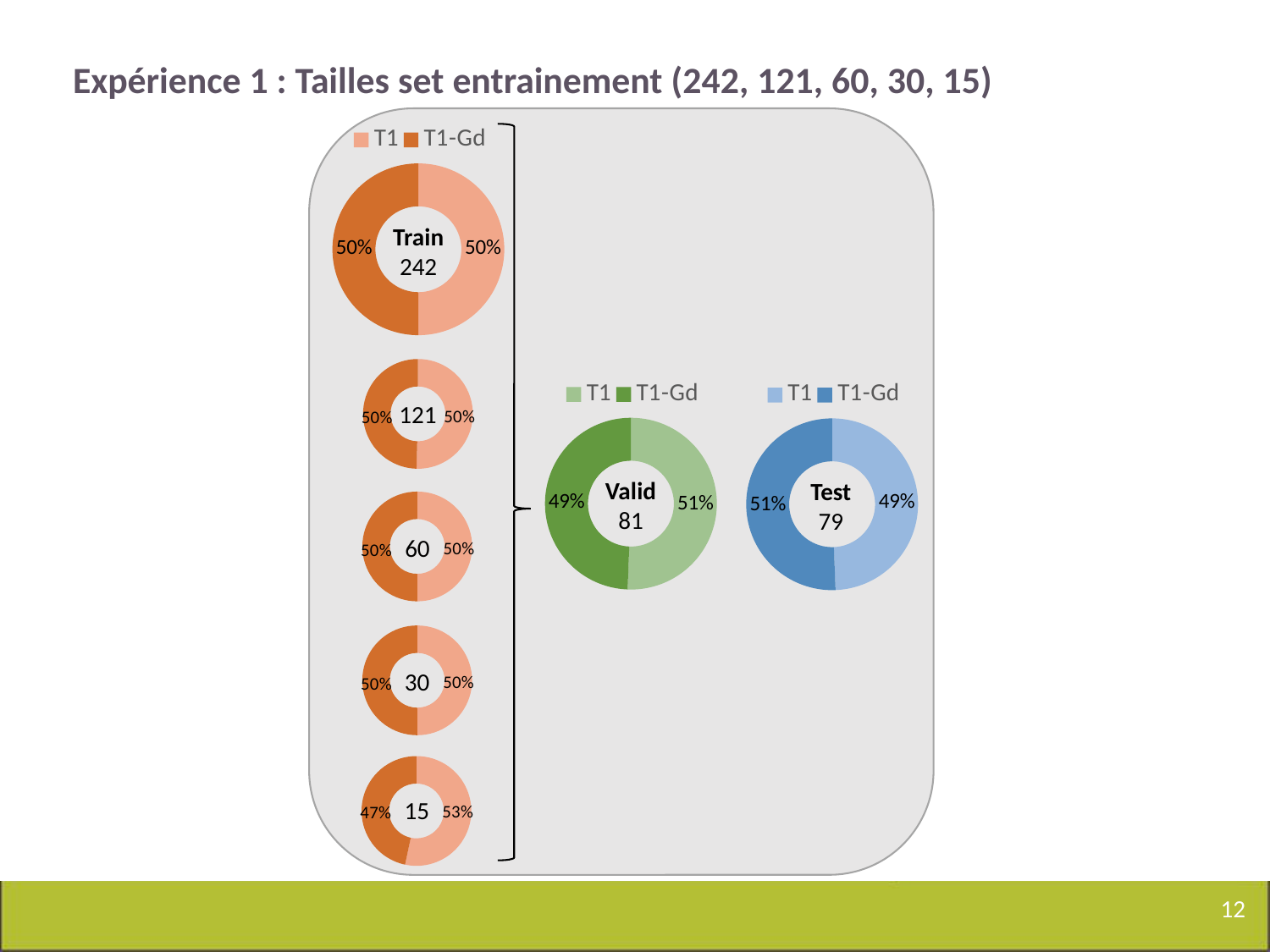
In the smallest training set donut (15), what share does T1-Gd have? 47% In the smallest training set donut (15), what share does T1 have? 53% In the training set donut of size 15, which slice is larger, T1 or T1-Gd? T1 In the Valid 81 donut chart, what share does T1 have? 51% How many series does the legend of the Valid chart list? 2 What kind of chart is used for the Train 242 set on the slide? Pie (donut) chart How many training set donut charts are shown in the left column of the slide? 5 In the Test 79 donut chart, which slice is larger, T1 or T1-Gd? T1-Gd